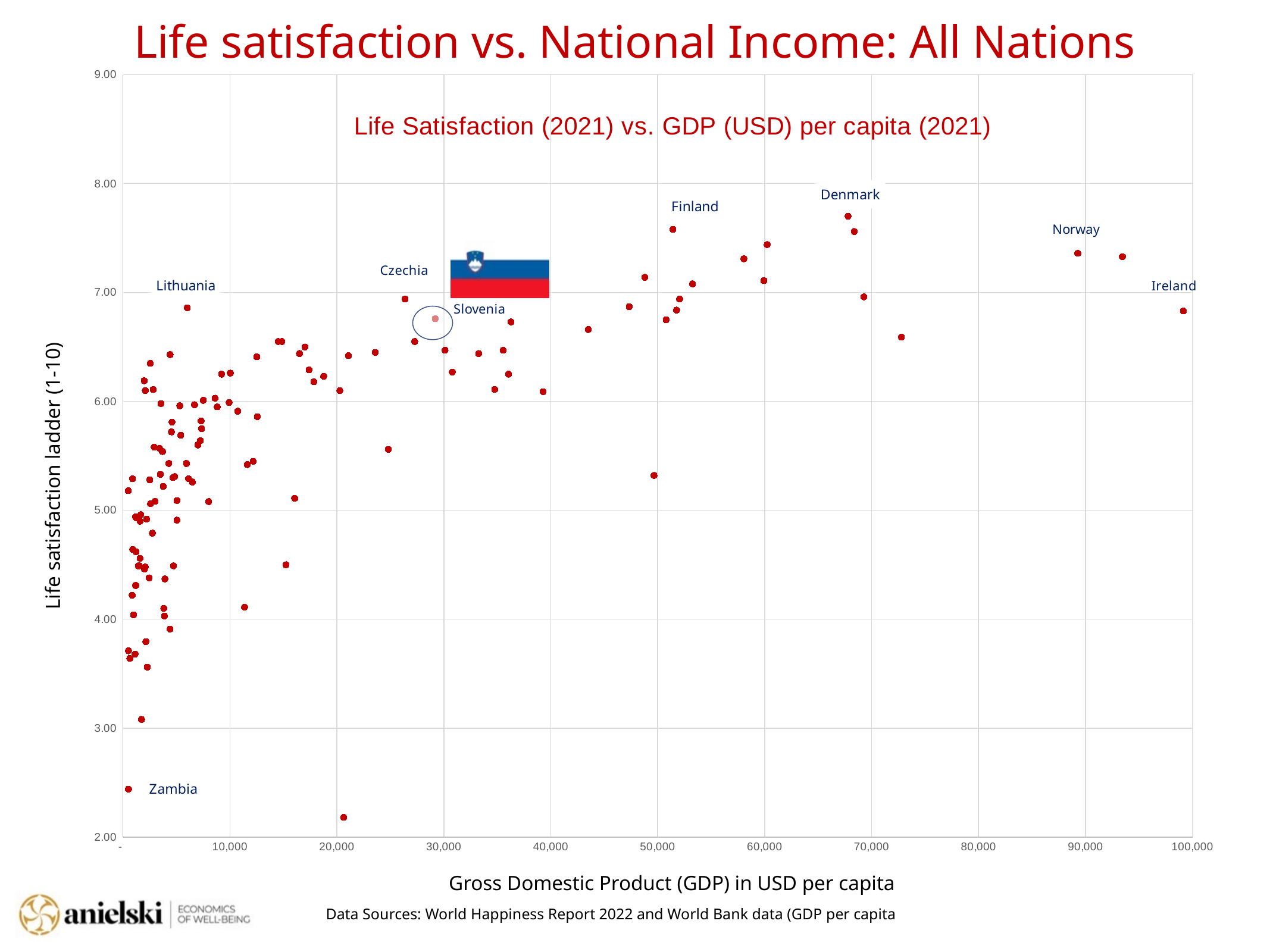
Which has the higher life satisfaction value, Denmark or Zambia? Denmark What is the label of the x axis? Gross Domestic Product (GDP) in USD per capita What kind of chart is shown on the slide? Scatter chart Is the life satisfaction value for Zambia greater or less than 3.00? less Which has the higher GDP per capita, Ireland or Lithuania? Ireland Is the life satisfaction value for Finland greater or less than 7.00? greater Is the GDP per capita for Slovenia greater or less than 40,000? less What is the title of the chart? Life Satisfaction (2021) vs. GDP (USD) per capita (2021) Do life satisfaction values generally rise or fall as GDP per capita increases along the x axis? Rise